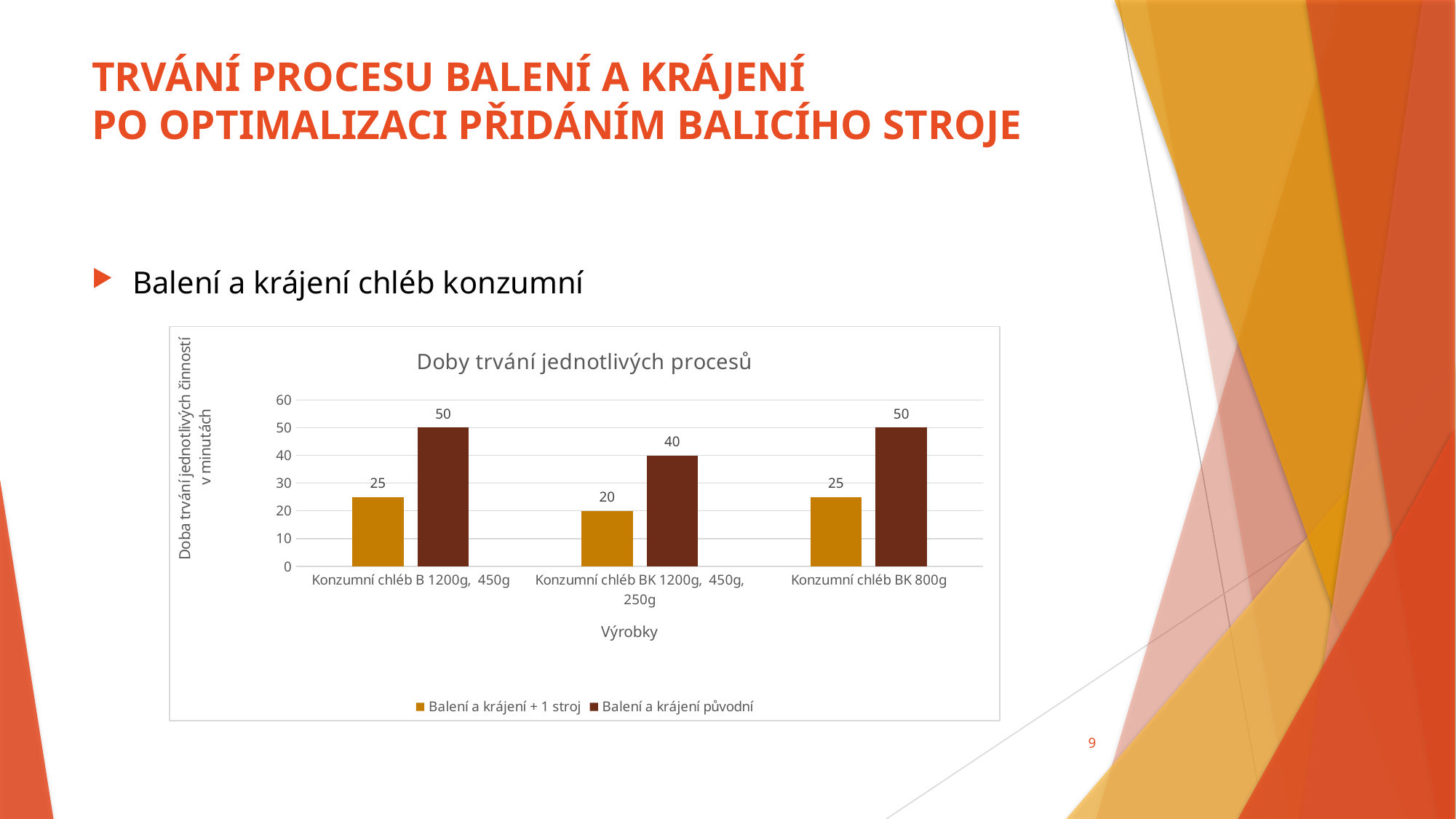
How many product categories are shown on the x axis? 3 What is the value for 'Balení a krájení + 1 stroj' for Konzumní chléb BK 800g? 25 What is the difference between 'Balení a krájení původní' and 'Balení a krájení + 1 stroj' for Konzumní chléb BK 1200g, 450g, 250g? 20 What is the difference between 'Balení a krájení původní' and 'Balení a krájení + 1 stroj' for Konzumní chléb B 1200g, 450g? 25 Which category has the lowest value for 'Balení a krájení původní'? Konzumní chléb BK 1200g, 450g, 250g What is the value for 'Balení a krájení + 1 stroj' for Konzumní chléb B 1200g, 450g? 25 What kind of chart is shown on the slide? Bar chart For Konzumní chléb BK 800g, which series has the larger value: 'Balení a krájení + 1 stroj' or 'Balení a krájení původní'? Balení a krájení původní What is the title of the chart? Doby trvání jednotlivých procesů What is the value for 'Balení a krájení původní' for Konzumní chléb BK 1200g, 450g, 250g? 40 Which category has the lowest value for 'Balení a krájení + 1 stroj'? Konzumní chléb BK 1200g, 450g, 250g How many series does the legend list? 2